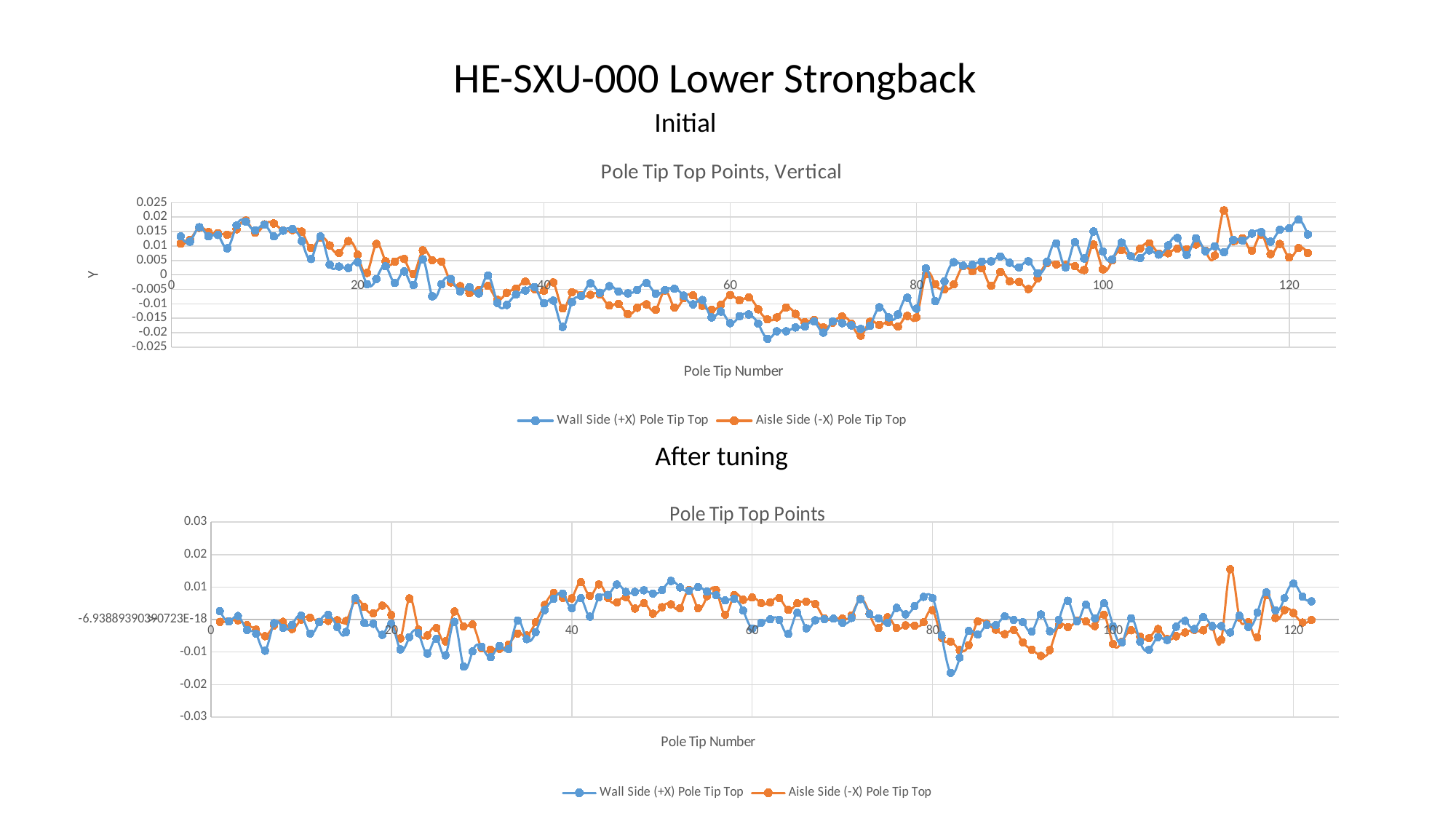
What is the x-axis label of the bottom chart titled "Pole Tip Top Points"? Pole Tip Number In the top chart (Initial), is the Aisle Side (-X) Pole Tip Top value at its spike near pole tip number 113 greater or less than 0.01? greater How many series does the legend of the top chart (Initial) list? 2 In the top chart (Initial), do the Wall Side (+X) Pole Tip Top values generally rise or fall between pole tip number 60 and pole tip number 120? rise In the top chart (Initial), is the Wall Side (+X) Pole Tip Top value at pole tip number 64 greater or less than -0.01? less What kind of chart is the top chart titled "Pole Tip Top Points, Vertical"? line chart In the bottom chart (After tuning), which series is drawn in orange? Aisle Side (-X) Pole Tip Top In the top chart (Initial), which series reaches the highest single point? Aisle Side (-X) Pole Tip Top In the top chart (Initial), do the Wall Side (+X) Pole Tip Top values generally rise or fall between pole tip number 0 and pole tip number 60? fall In the bottom chart (After tuning), which series reaches the lowest single point? Wall Side (+X) Pole Tip Top In the bottom chart (After tuning), is the lowest Wall Side (+X) Pole Tip Top value, near pole tip number 82, greater or less than -0.01? less